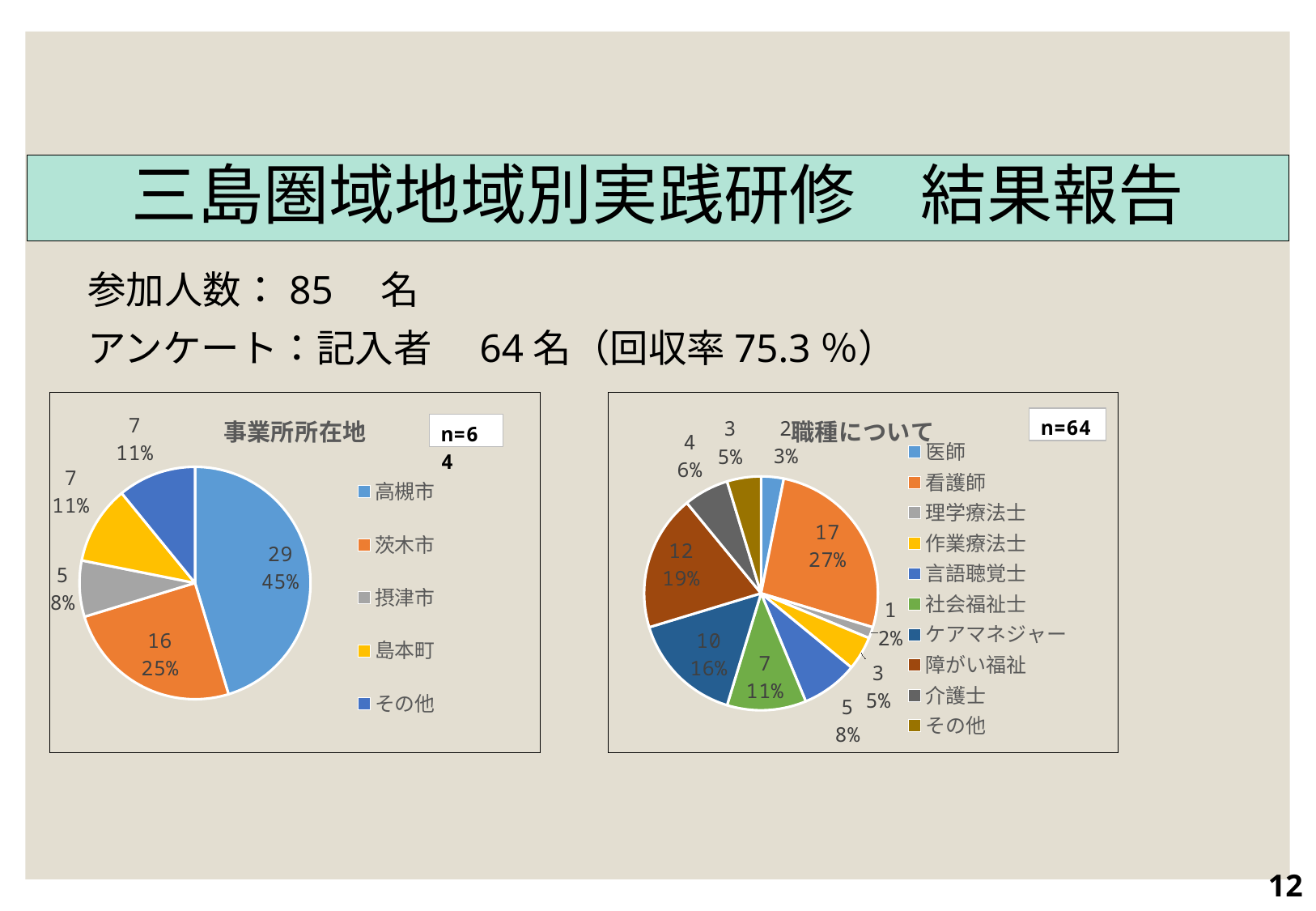
How many categories does the legend of the 職種について pie chart list? 10 In the 事業所所在地 pie chart, what percentage share does 茨木市 have? 25% In the 職種について pie chart, what is the value for 看護師? 17 In the 事業所所在地 pie chart, what is the difference between the values for 高槻市 and 茨木市? 13 In the 職種について pie chart, which category has the smallest value? 理学療法士 In the 職種について pie chart, what percentage share does 障がい福祉 have? 19% In the 職種について pie chart, which is larger, the value for ケアマネジャー or the value for 社会福祉士? ケアマネジャー In the 職種について pie chart, which category has the largest value? 看護師 In the 事業所所在地 pie chart, which category has the smallest value? 摂津市 What type of chart is the 職種について chart? pie chart How many categories does the 事業所所在地 pie chart show? 5 In the 事業所所在地 pie chart, what is the value for 高槻市? 29